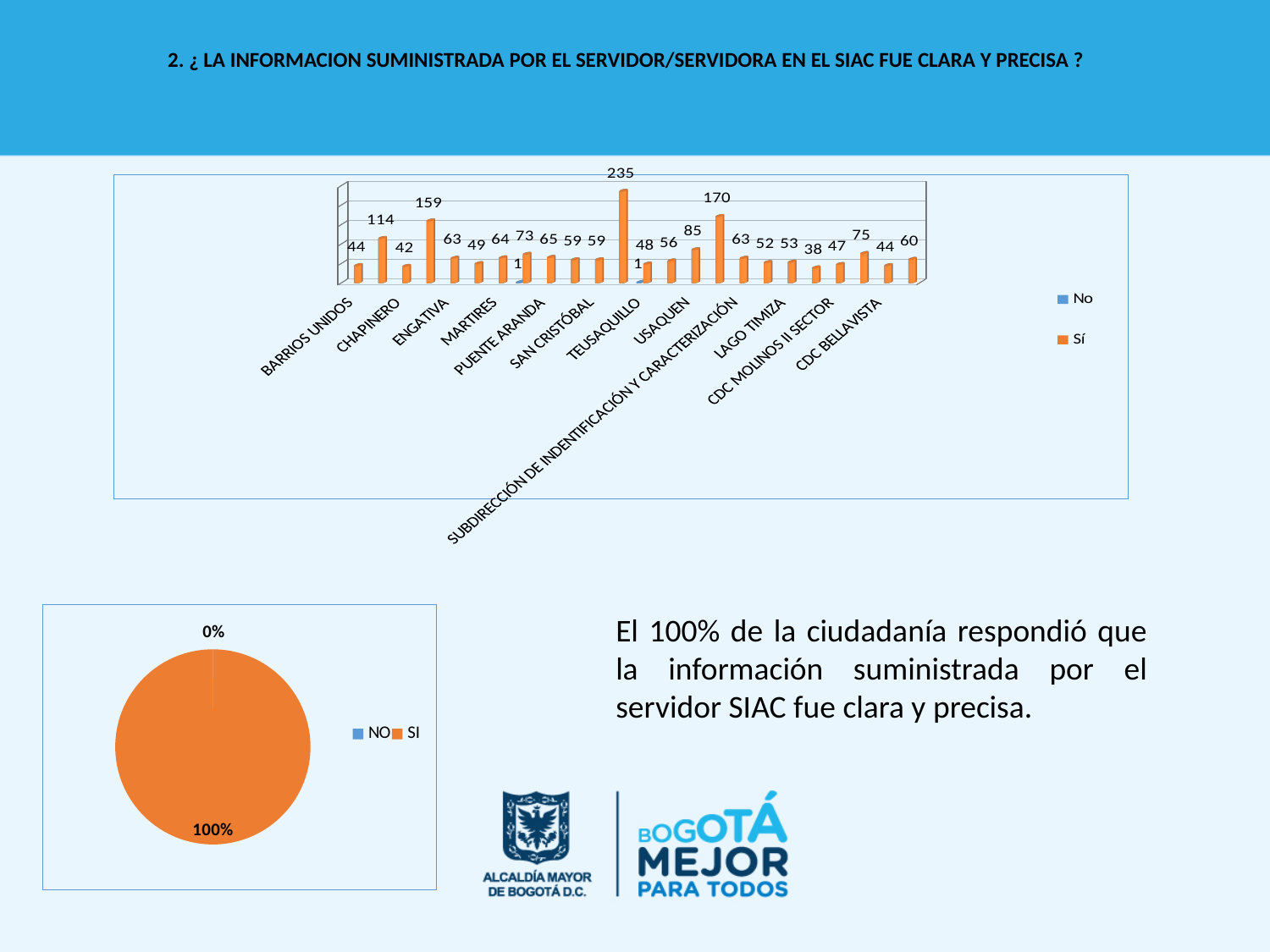
What kind of chart is the bottom-left chart on the slide? pie chart How many series does the legend of the top chart list? 2 In the top chart, which is larger: the bar labelled 159 or the bar labelled 114? 159 In the bottom-left pie chart, what share does NO have? 0% In the top chart, what is the lowest value shown by a data label? 1 In the bottom-left pie chart, which slice is larger, NO or SI? SI What kind of chart is the top chart on the slide? bar chart In the top chart, what is the difference between the two largest labelled values, 235 and 170? 65 What are the two legend entries of the top chart? No and Sí In the bottom-left pie chart, what share does SI have? 100% In the top chart, what is the highest value shown by a data label? 235 How many series does the legend of the bottom-left pie chart list? 2